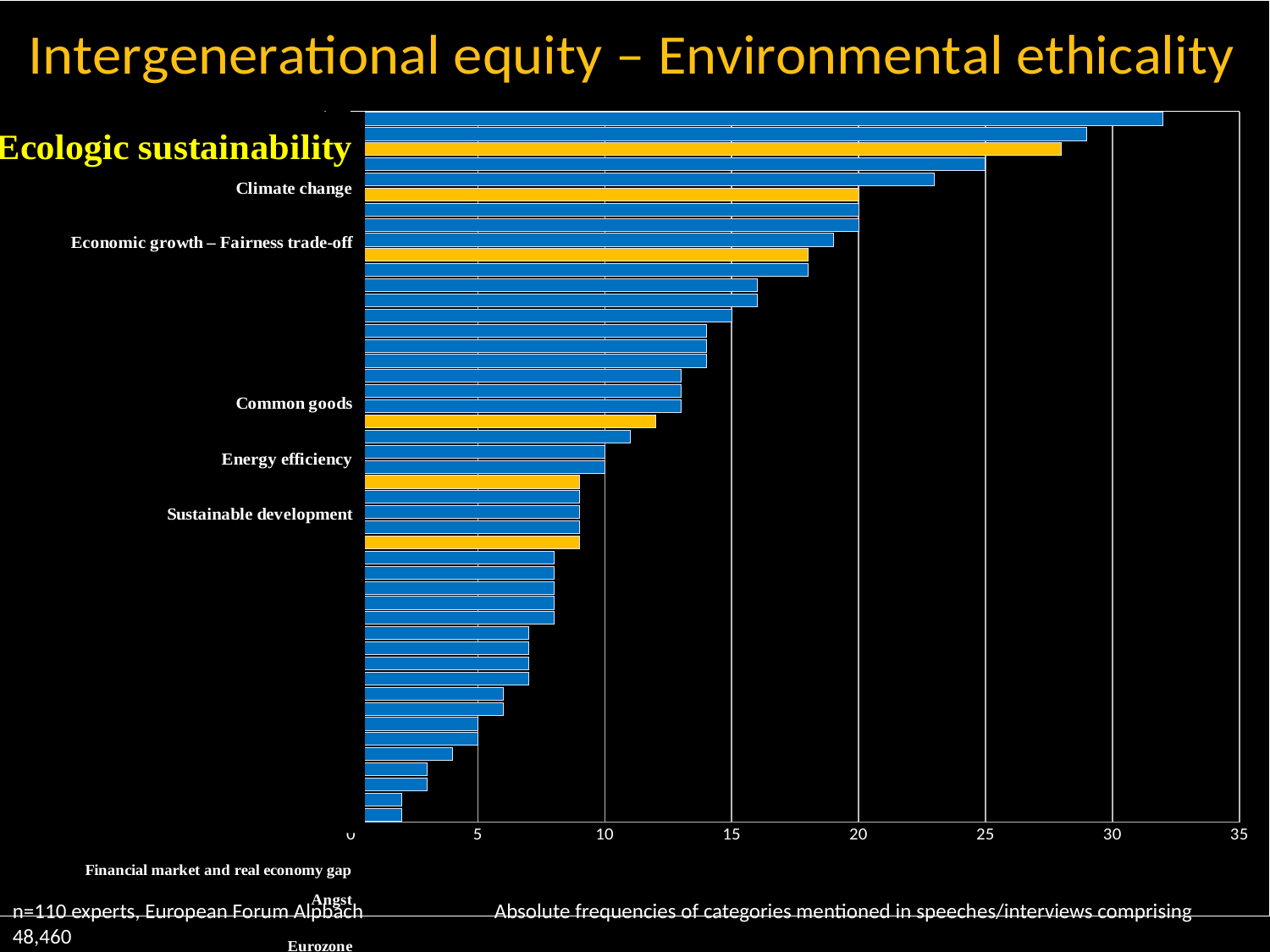
Which is larger, the value for Ecologic sustainability or the value for Climate change? Ecologic sustainability Among the labelled categories, which has the highest value? Ecologic sustainability Is the value for Economic growth – Fairness trade-off greater or less than 20? less Is the value for Common goods greater or less than 10? greater Is the value for Ecologic sustainability greater or less than 25? greater What is the highest value shown on the horizontal axis? 35 What is the value for Climate change? 20 What kind of chart is shown on the slide? bar chart Which is larger, the value for Climate change or the value for Common goods? Climate change